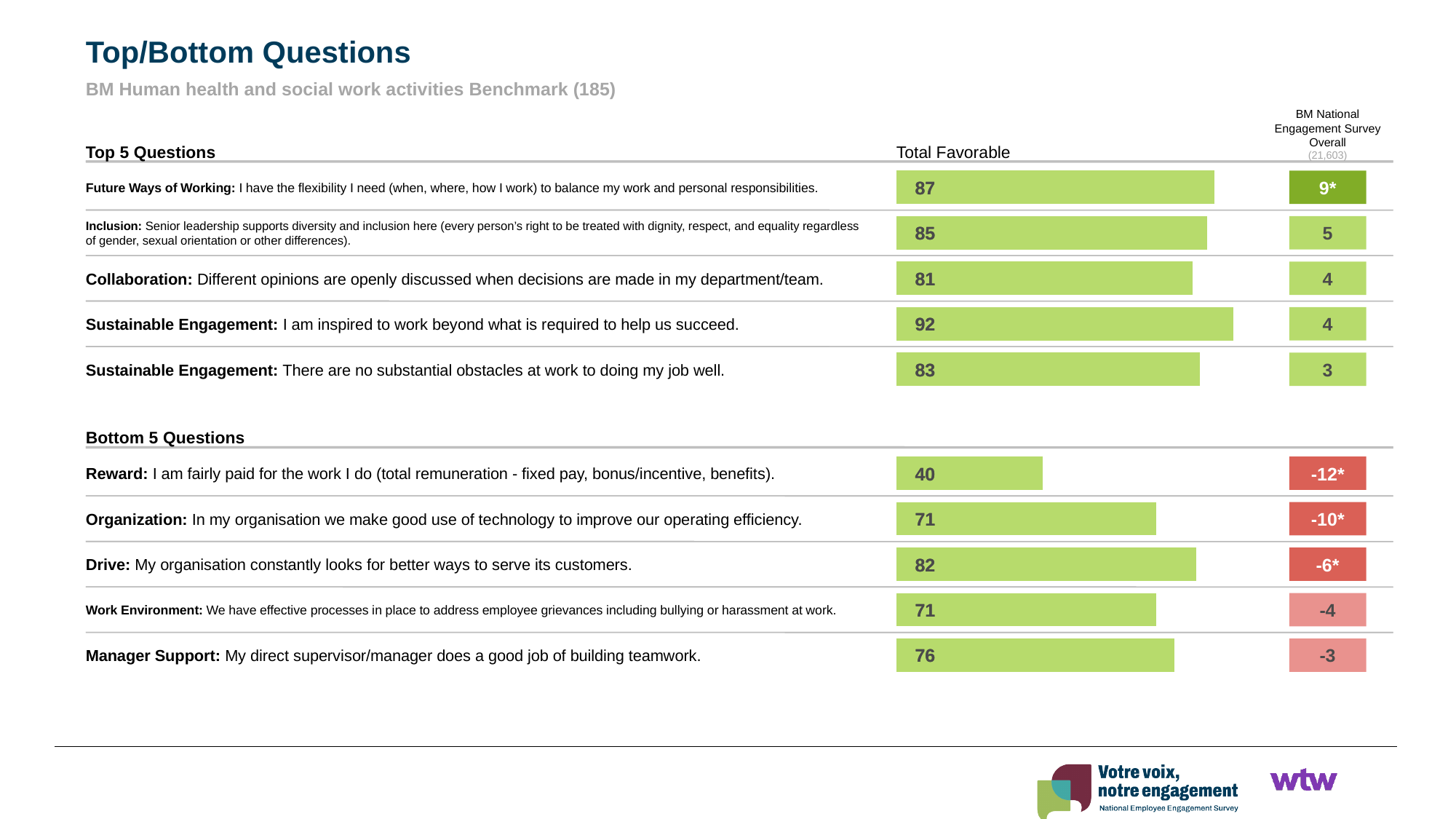
In the Bottom 5 Questions chart, what is the BM National Engagement Survey Overall comparison value for the 'Reward' question? -12* In the Top 5 Questions chart, what is the Total Favorable value for 'Sustainable Engagement: I am inspired to work beyond what is required to help us succeed'? 92 In the Top 5 Questions chart, which question has the highest Total Favorable value? Sustainable Engagement: I am inspired to work beyond what is required to help us succeed. In the Top 5 Questions chart, what is the BM National Engagement Survey Overall comparison value for the 'Future Ways of Working' question? 9* In the Bottom 5 Questions chart, which question has the highest Total Favorable value? Drive: My organisation constantly looks for better ways to serve its customers. How many questions are shown in the Bottom 5 Questions chart? 5 In the Bottom 5 Questions chart, what is the Total Favorable value for 'Reward: I am fairly paid for the work I do'? 40 In the Bottom 5 Questions chart, what is the difference in Total Favorable between the 'Manager Support' question and the 'Reward' question? 36 In the Bottom 5 Questions chart, which has a larger Total Favorable value: the 'Drive' question or the 'Organization' question? Drive In the Top 5 Questions chart, what is the difference in Total Favorable between the 'Future Ways of Working' question and the 'Inclusion' question? 2 In the Bottom 5 Questions chart, which question has the lowest Total Favorable value? Reward: I am fairly paid for the work I do (total remuneration - fixed pay, bonus/incentive, benefits). In the Top 5 Questions chart, what is the Total Favorable value for 'Collaboration: Different opinions are openly discussed when decisions are made in my department/team'? 81